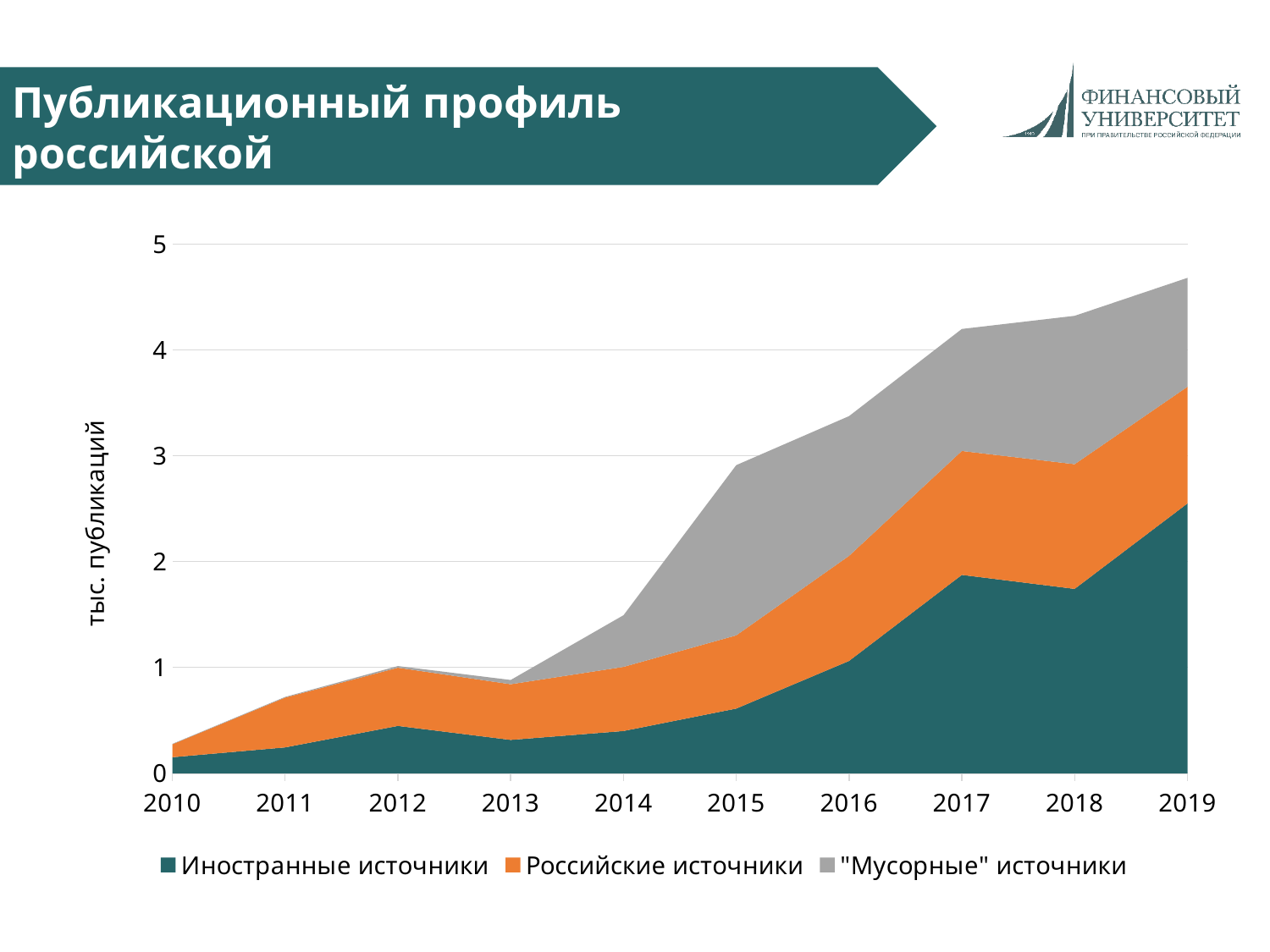
What kind of chart is shown on the slide? Stacked area chart What is the label on the vertical axis? тыс. публикаций Is the total value for 2010 greater or less than 1? less How many years are plotted along the x axis? 10 Is the value for Иностранные источники in 2019 greater or less than 2? greater Does the total number of publications generally rise or fall from 2010 to 2019? Rise Is the total value for 2017 greater or less than 4? greater Which year has the highest total number of publications? 2019 How many series does the legend list? 3 Which year has the lowest total number of publications? 2010